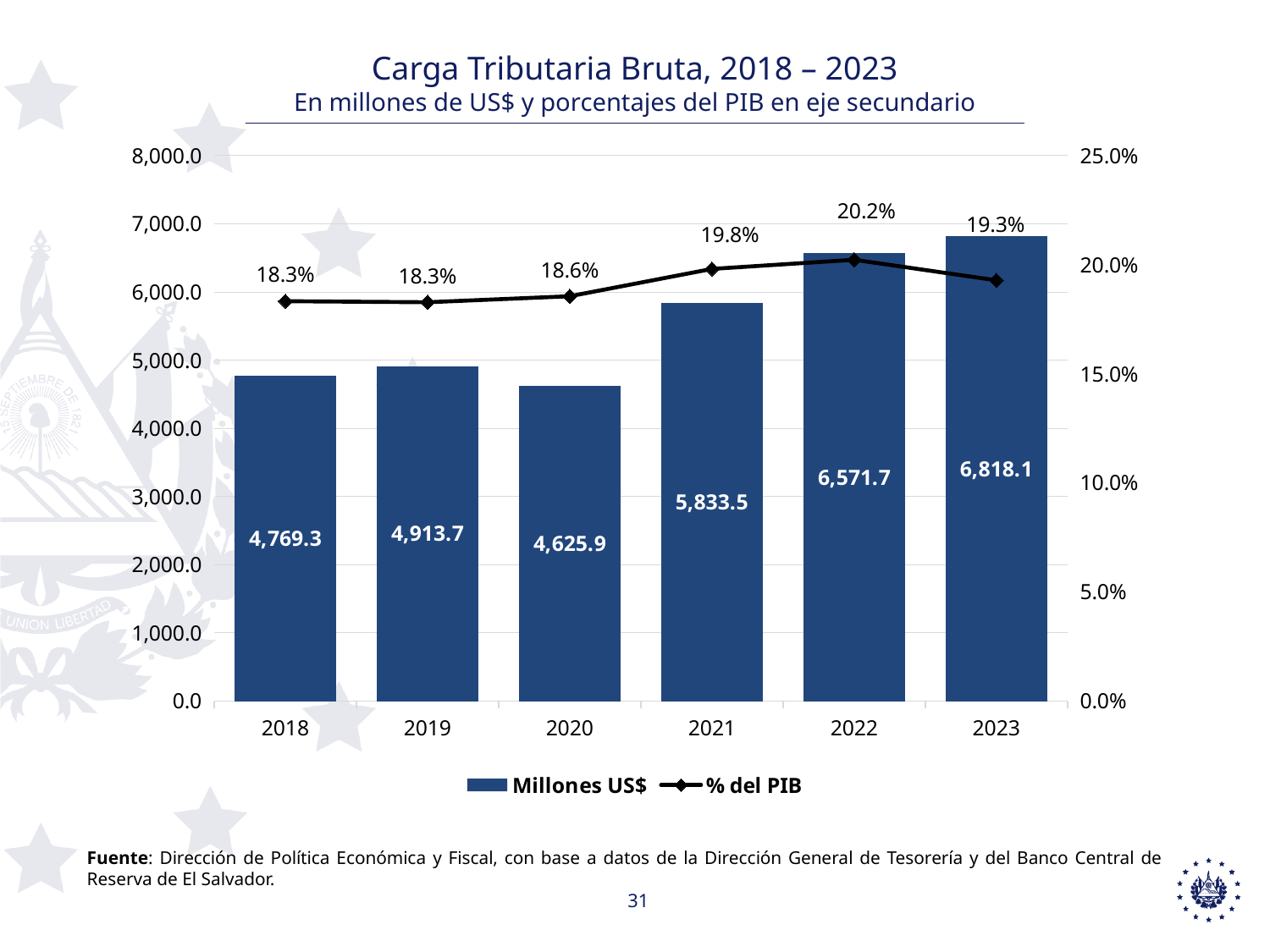
What kind of chart is used for the Millones US$ series? bar chart Which year has the lowest Millones US$ value? 2020 How many series does the legend list? 2 What is the value of Millones US$ for 2020? 4,625.9 What is the value of Millones US$ for 2021? 5,833.5 What is the % del PIB value for 2022? 20.2% How many years are shown on the x axis? 6 What is the difference in Millones US$ between 2023 and 2022? 246.4 Which year has a larger Millones US$ value, 2019 or 2021? 2021 What is the title of the chart? Carga Tributaria Bruta, 2018 – 2023 Which year has the highest Millones US$ value? 2023 Is the Millones US$ value for 2022 greater or less than 6,000.0? greater